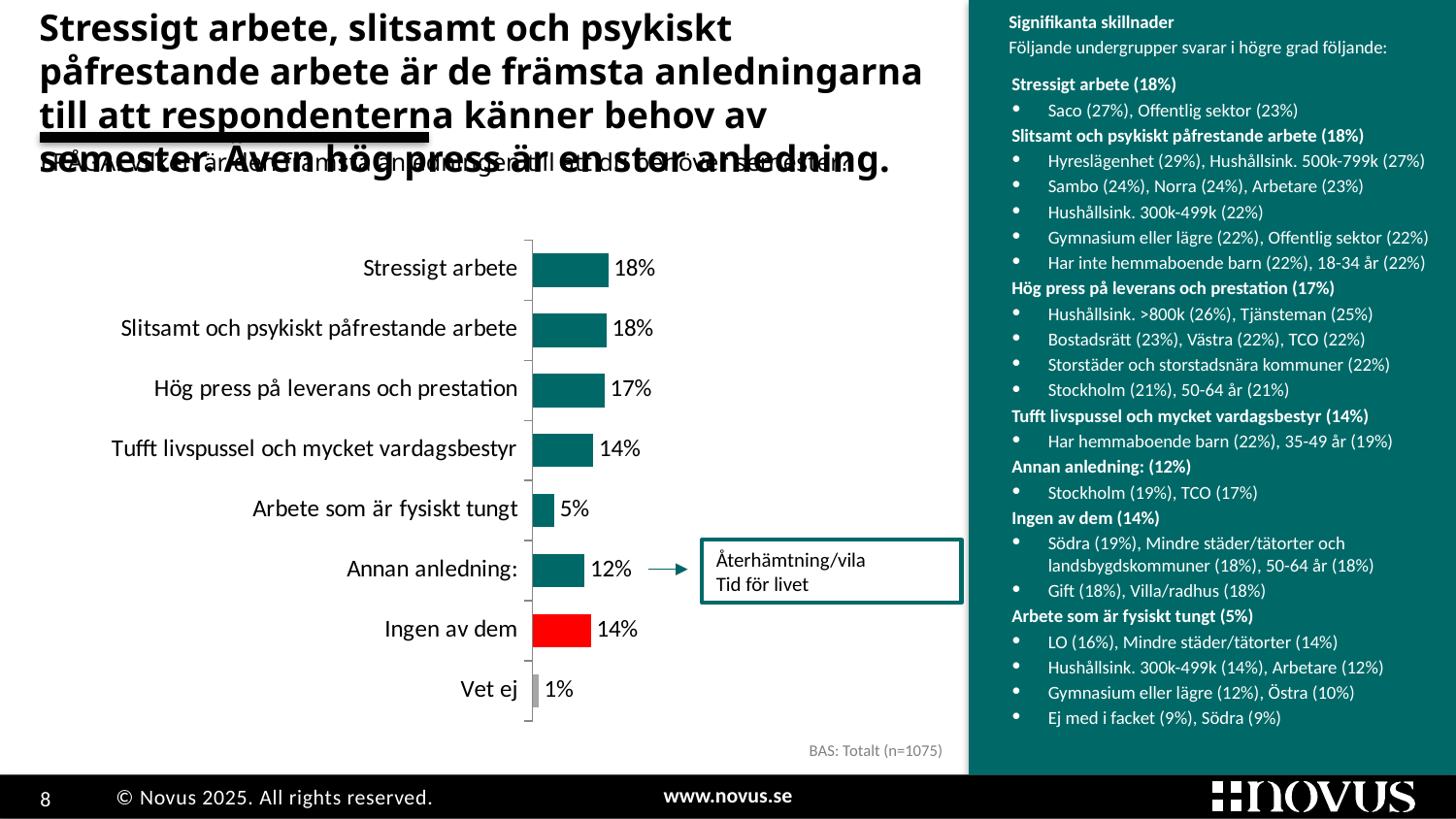
Which category has the lowest value? Vet ej What is the difference between Slitsamt och psykiskt påfrestande arbete and Tufft livspussel och mycket vardagsbestyr? 4 percentage points How many categories are shown in the chart? 8 What kind of chart is shown on the slide? Bar chart What is the value for Ingen av dem? 14% What is the value for Arbete som är fysiskt tungt? 5% What text is in the callout box pointing from the Annan anledning: bar? Återhämtning/vila, Tid för livet What is the value for Hög press på leverans och prestation? 17% Which bar in the chart is coloured red? Ingen av dem What is the value for Stressigt arbete? 18% What is the value for Annan anledning:? 12% Which is larger: Hög press på leverans och prestation or Annan anledning:? Hög press på leverans och prestation